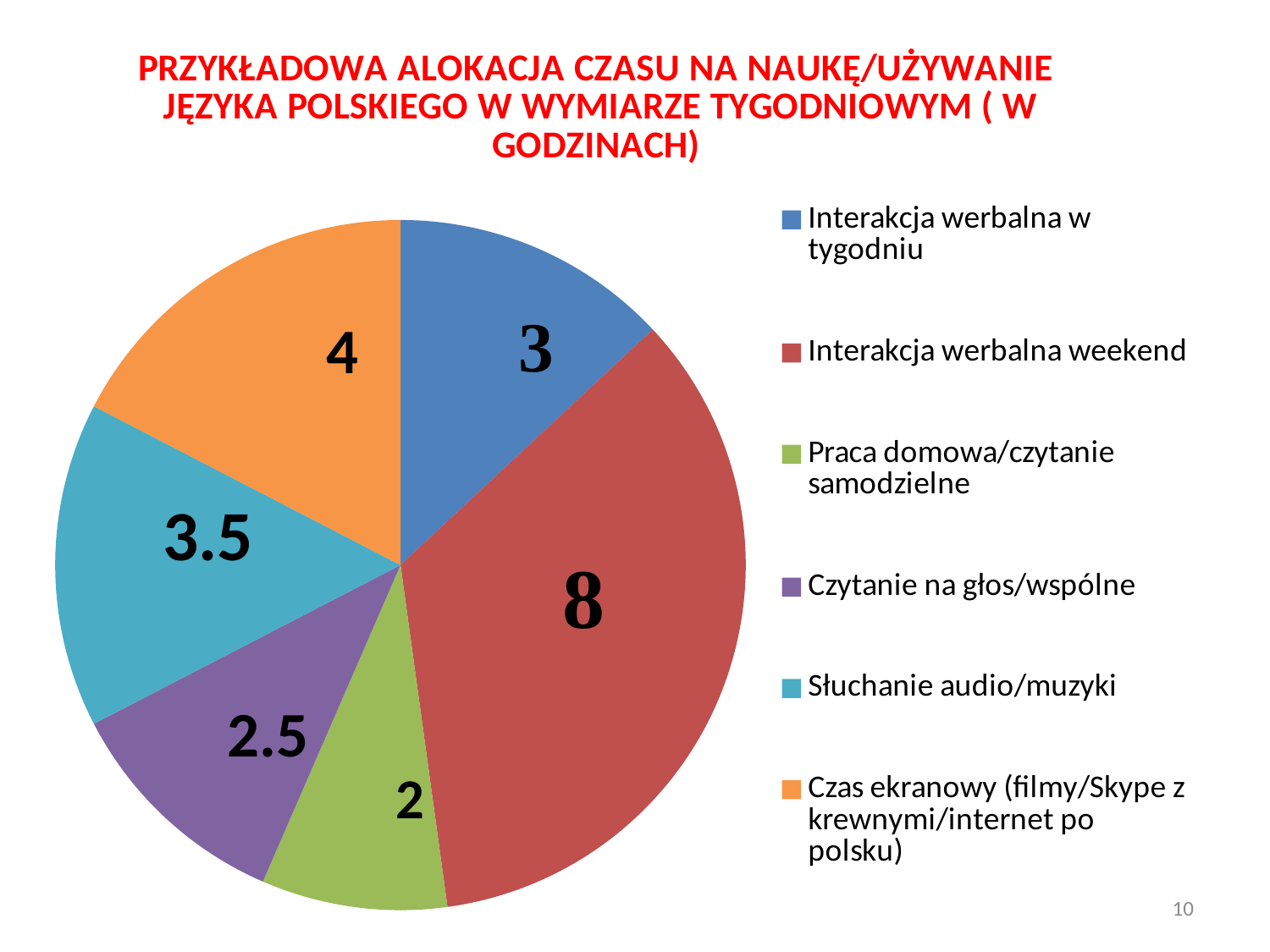
What is the difference between the values for Interakcja werbalna weekend and Interakcja werbalna w tygodniu? 5 What type of chart is shown on the slide? pie chart What is the value for Słuchanie audio/muzyki? 3.5 Which is larger, the value for Słuchanie audio/muzyki or the value for Interakcja werbalna w tygodniu? Słuchanie audio/muzyki What is the value for Czas ekranowy (filmy/Skype z krewnymi/internet po polsku)? 4 What is the value for Czytanie na głos/wspólne? 2.5 Which category has the smallest slice? Praca domowa/czytanie samodzielne How many slices does the pie chart have? 6 Which category has the largest slice? Interakcja werbalna weekend What is the value for Interakcja werbalna weekend? 8 What is the total of all the values shown in the pie chart? 23 What colour is the slice for Praca domowa/czytanie samodzielne? green